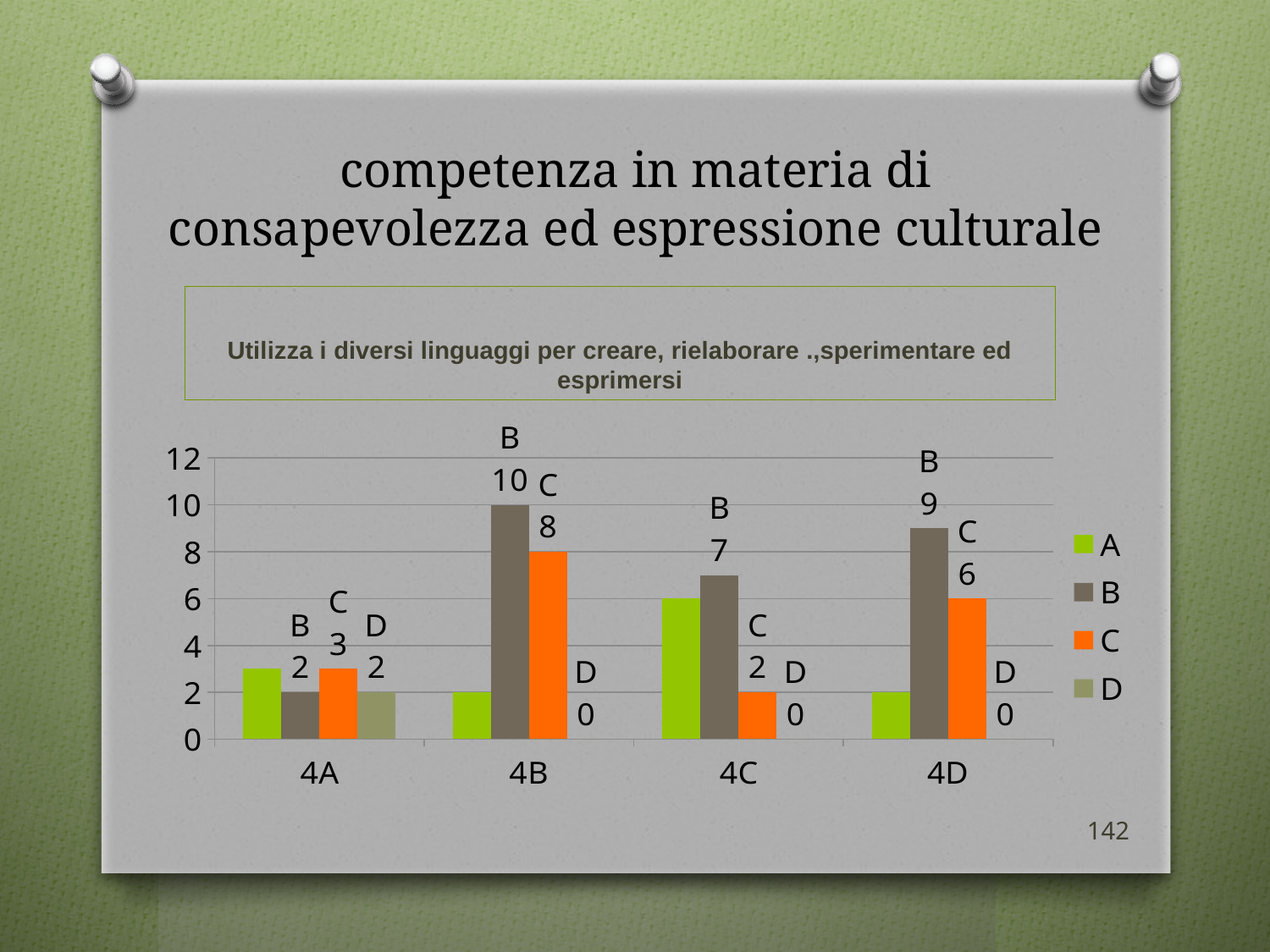
What is the difference between series B and series C for category 4B? 2 What is the value of series B for category 4B? 10 How many categories are shown on the x axis? 4 What is the value of series C for category 4D? 6 Which category has the lowest value for series C? 4C Which is larger: series C for 4B or series C for 4D? 4B Is the value of series A for category 4C greater or less than 4? greater How many series does the legend list? 4 What is the value of series D for category 4C? 0 What is the value of series D for category 4A? 2 Which category has the highest value for series B? 4B What kind of chart is shown on the slide? bar chart